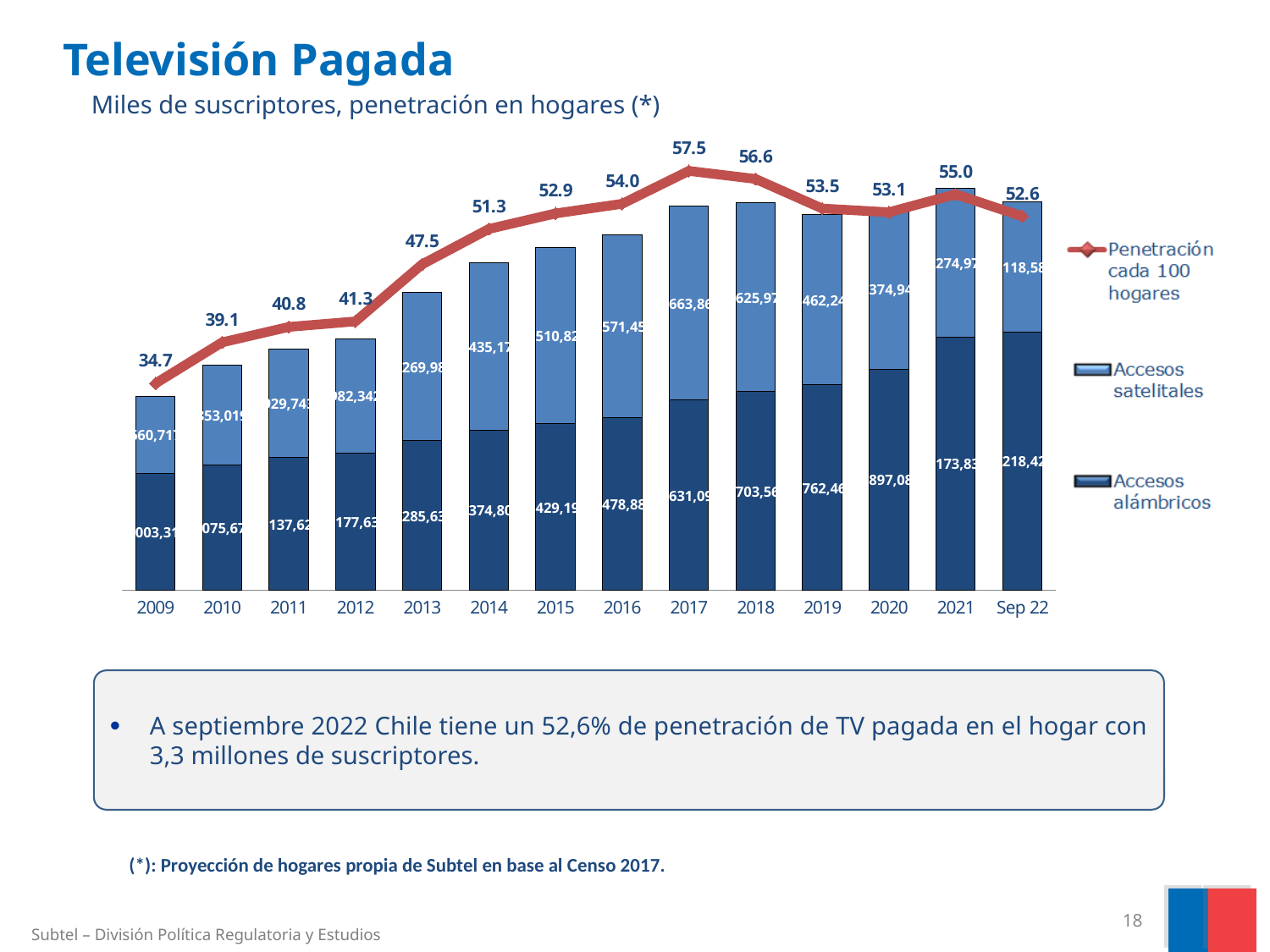
How many periods are shown on the x axis of the chart? 14 What is the value of Penetración cada 100 hogares for 2009? 34.7 How many series does the legend list? 3 Does Penetración cada 100 hogares rise or fall from 2009 to 2017? rise What is the difference in Penetración cada 100 hogares between 2017 and Sep 22? 4.9 Which year has a higher Penetración cada 100 hogares, 2018 or 2019? 2018 In which year is Penetración cada 100 hogares lowest? 2009 In 2021, which segment is larger, Accesos alámbricos or Accesos satelitales? Accesos alámbricos What is the value of Penetración cada 100 hogares for 2017? 57.5 In which year is Penetración cada 100 hogares highest? 2017 What is the difference in Penetración cada 100 hogares between 2010 and 2009? 4.4 What is the value of Penetración cada 100 hogares for Sep 22? 52.6